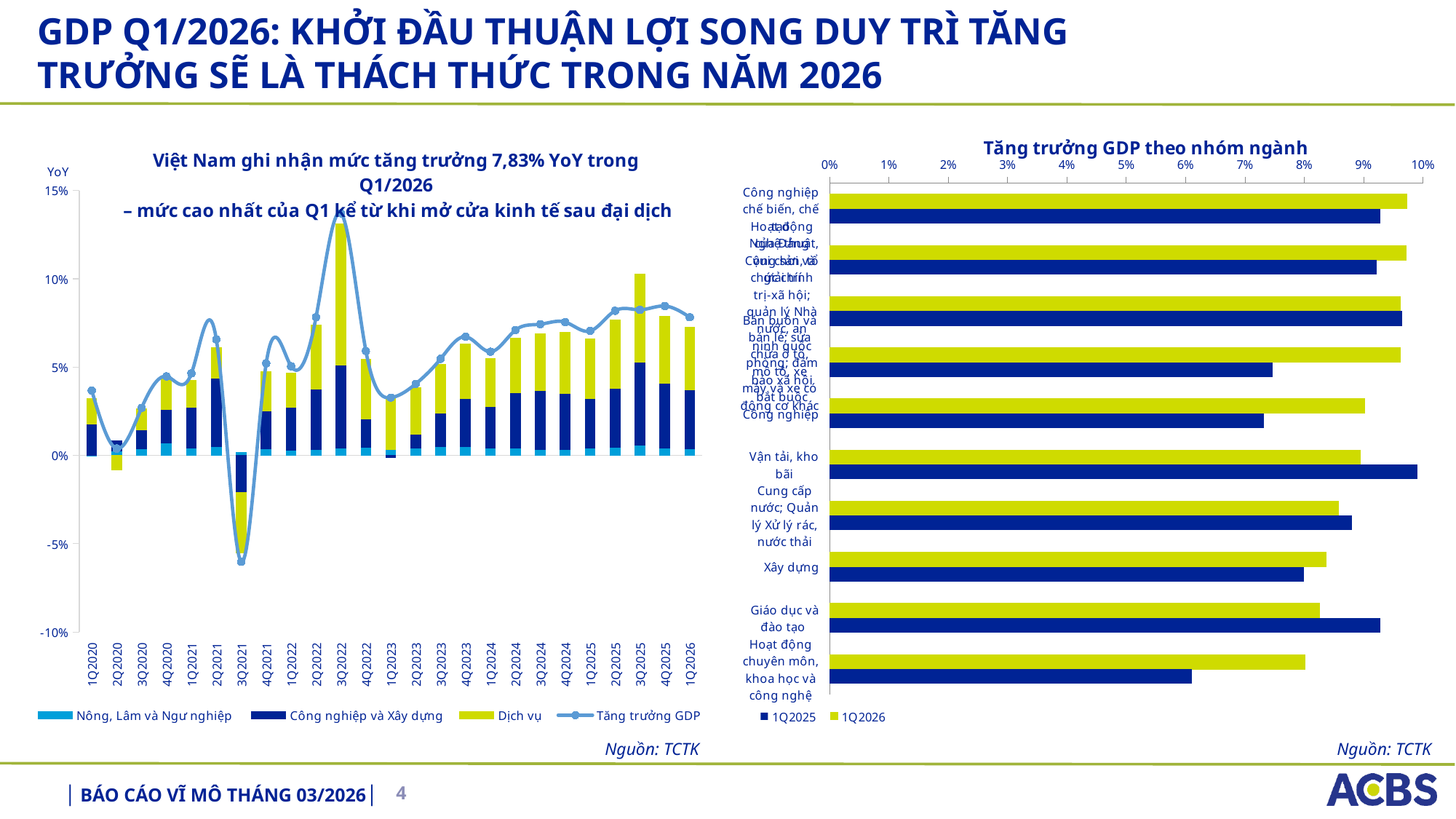
On the right chart 'Tăng trưởng GDP theo nhóm ngành', is the 1Q2025 value for 'Hoạt động chuyên môn, khoa học và công nghệ' greater or less than 7%? less On the left chart, in which quarter is the 'Tăng trưởng GDP' line at its highest? 3Q2022 On the right chart 'Tăng trưởng GDP theo nhóm ngành', what kind of chart is it? Bar chart On the left chart, how many series does the legend list? 4 On the right chart 'Tăng trưởng GDP theo nhóm ngành', which series is larger for 'Vận tải, kho bãi', 1Q2025 or 1Q2026? 1Q2025 On the right chart 'Tăng trưởng GDP theo nhóm ngành', which series is larger for 'Giáo dục và đào tạo', 1Q2025 or 1Q2026? 1Q2025 On the right chart 'Tăng trưởng GDP theo nhóm ngành', how many series does the legend list? 2 On the right chart 'Tăng trưởng GDP theo nhóm ngành', which series is larger for 'Hoạt động chuyên môn, khoa học và công nghệ', 1Q2025 or 1Q2026? 1Q2026 On the right chart 'Tăng trưởng GDP theo nhóm ngành', is the 1Q2025 value for 'Vận tải, kho bãi' greater or less than 9%? greater On the left chart, how many quarters are shown on the x axis? 25 On the left chart, is the 'Tăng trưởng GDP' value for 3Q2021 greater or less than -5%? less On the left chart, in which quarter is the 'Tăng trưởng GDP' line at its lowest? 3Q2021